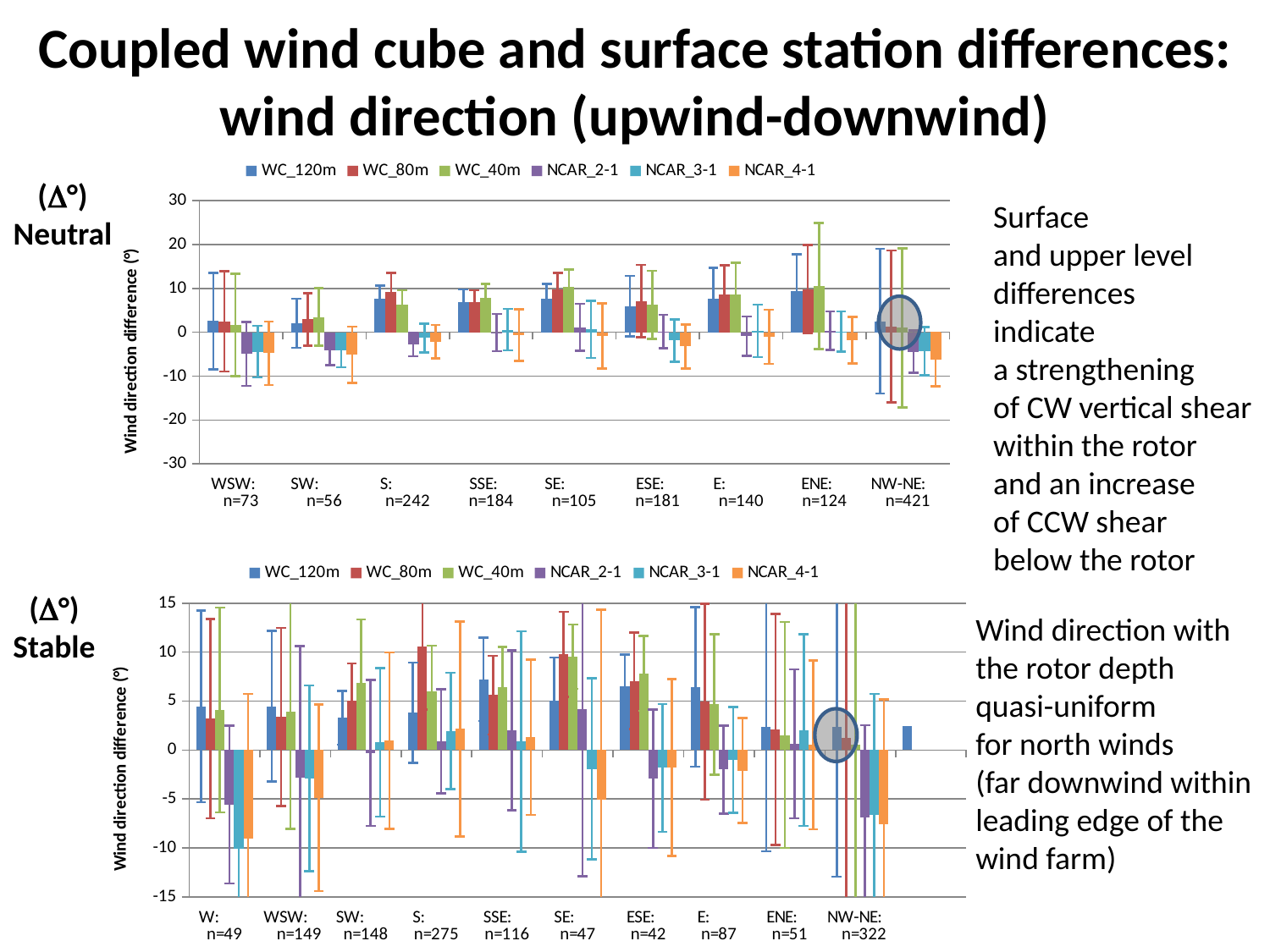
In the bottom (Stable) chart, which is larger: the WC_80m value for S or the WC_80m value for W? S How many wind direction categories are shown on the x axis of the top (Neutral) chart? 9 How many series does the legend of the top (Neutral) chart list? 6 What is the sample size (n) shown for the NW-NE category in the top (Neutral) chart? n=421 In the bottom (Stable) chart, is the NCAR_4-1 value for W greater or less than -5? less In the top (Neutral) chart, which category has the highest WC_120m bar? ENE: n=124 How many wind direction categories are shown on the x axis of the bottom (Stable) chart? 10 In the top (Neutral) chart, is the NCAR_4-1 value for WSW greater or less than 0? less In the top (Neutral) chart, which is larger: the WC_120m value for ENE or the WC_120m value for WSW? ENE What kind of chart is the top (Neutral) chart? bar chart In the top (Neutral) chart, is the WC_120m value for ENE greater or less than 0? greater